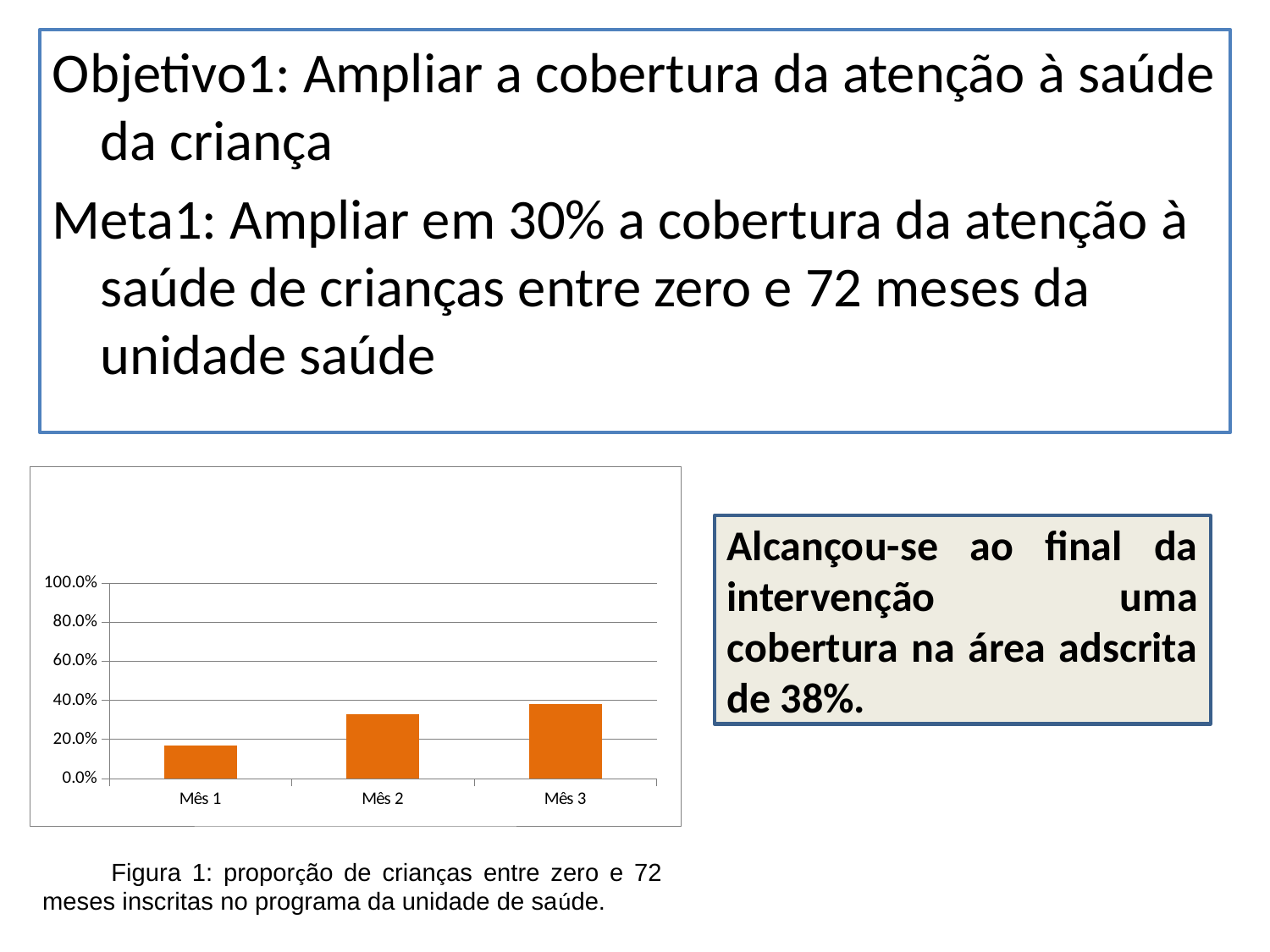
What kind of chart is shown on the slide? bar chart Do the values rise or fall from Mês 1 to Mês 3? rise Which month has the lowest bar in the chart? Mês 1 Is the value for Mês 2 greater or less than 40.0%? less Which month has the highest bar in the chart? Mês 3 Is the value for Mês 3 greater or less than 60.0%? less Is the value for Mês 2 greater or less than 20.0%? greater What colour are the bars in the chart? orange Which is larger, the value for Mês 1 or the value for Mês 2? Mês 2 How many categories (months) are shown on the x axis of the chart? 3 What is the highest value shown on the y axis of the chart? 100.0%